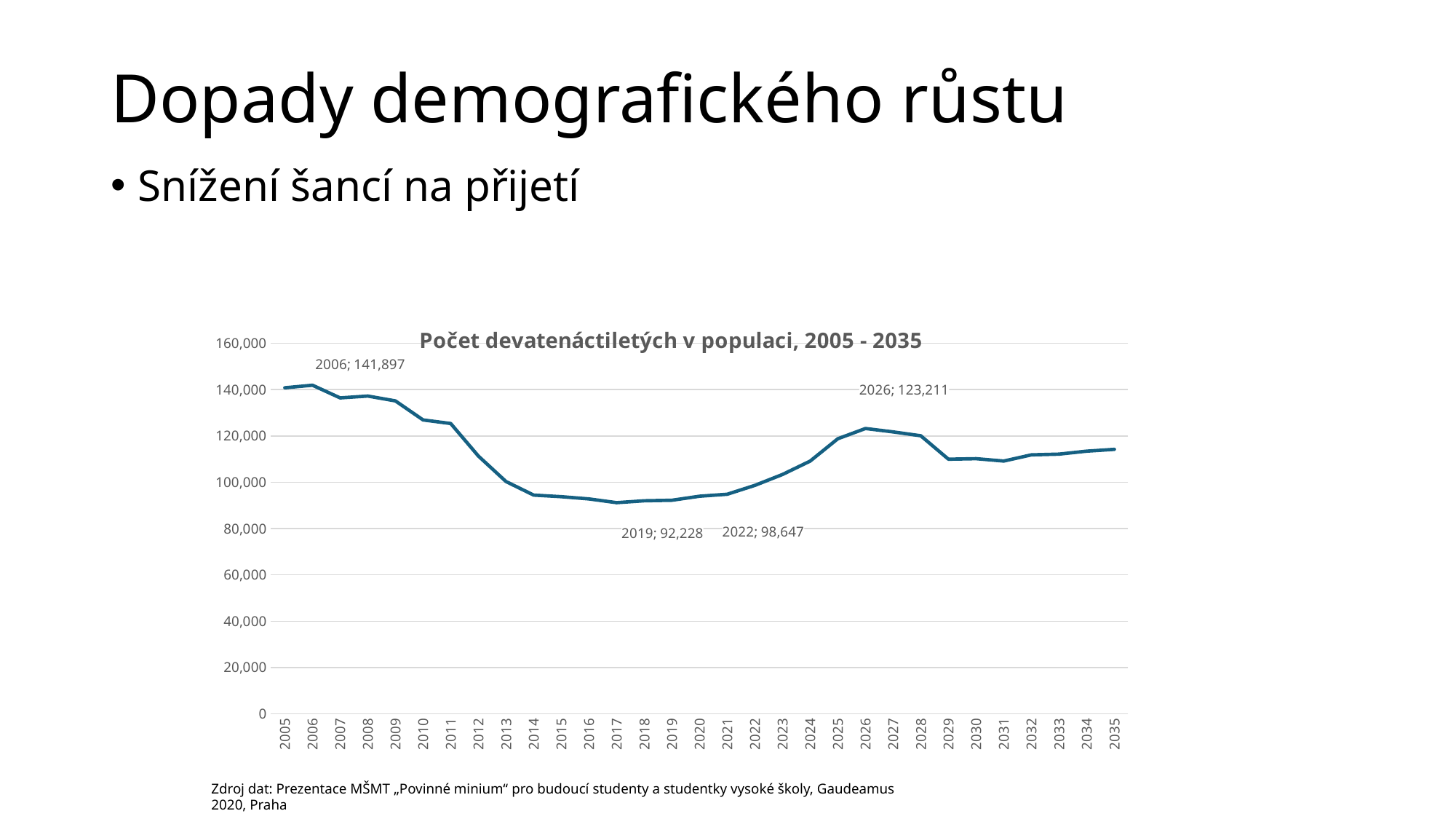
What is the value for 2022? 98,647 What is the value for 2019? 92,228 Which year has the highest value on the chart? 2006 Is the value for 2029 greater or less than 100,000? greater Which year has the larger value, 2006 or 2026? 2006 What is the difference between the values for 2026 and 2022? 24,564 What kind of chart is shown on the slide? line chart What is the value for 2006? 141,897 What is the value for 2026? 123,211 What is the difference between the values for 2006 and 2019? 49,669 How many years are plotted on the x axis? 31 Is the value for 2014 greater or less than 100,000? less